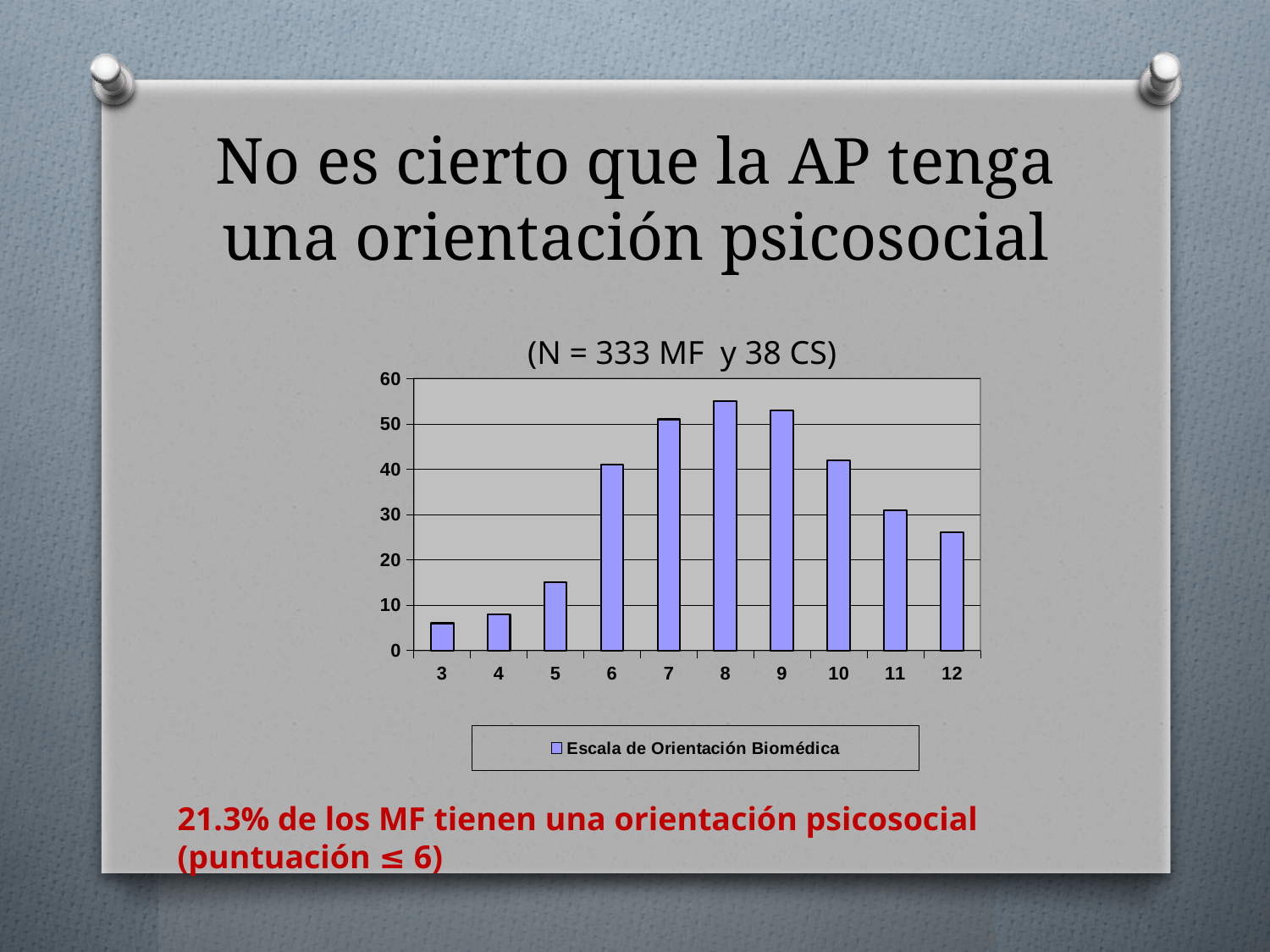
Is the value for score 8 greater or less than 50? greater Is the value for score 3 greater or less than 10? less What kind of chart is shown on the slide? bar chart How many series does the chart legend list? 1 What is the series name shown in the chart legend? Escala de Orientación Biomédica Is the value for score 12 greater or less than 30? less How many score categories are shown on the x axis of the chart? 10 Do the values rise or fall as the score goes from 8 to 12? fall Which score category has the highest bar in the chart? 8 Which has the larger value, score 6 or score 12? 6 Which score category has the lowest bar in the chart? 3